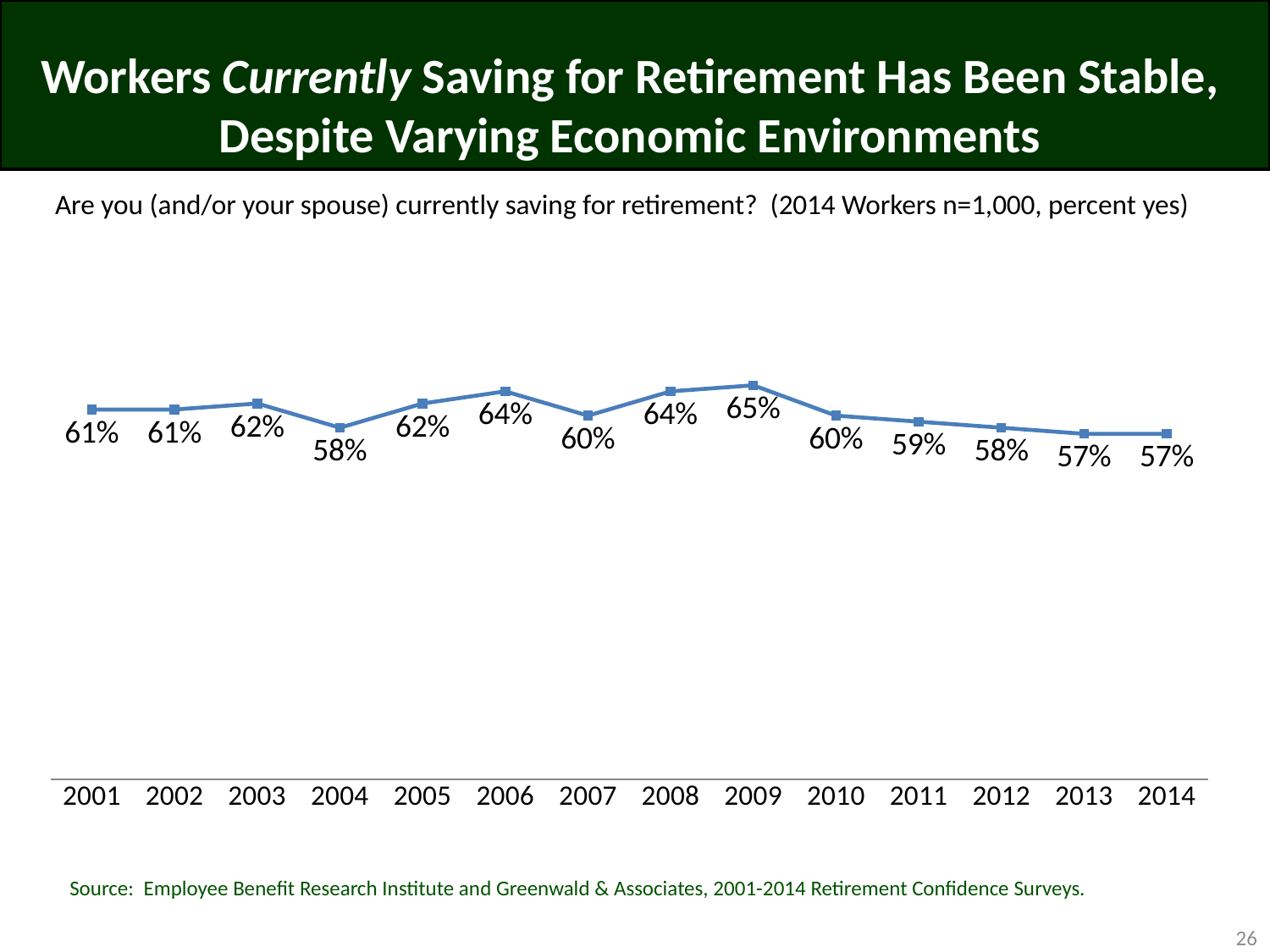
What is the difference between the 2009 value and the 2014 value? 8 percentage points What is the first year shown on the x axis? 2001 What is the value shown for 2014? 57% Do the values rise or fall from 2009 to 2014? Fall How many years are plotted on the chart? 14 Which is larger, the value for 2003 or the value for 2004? 2003 Which year has the highest percentage of workers currently saving for retirement? 2009 Which is larger, the value for 2008 or the value for 2010? 2008 What kind of chart is shown on the slide? Line chart What percentage of workers reported currently saving for retirement in 2009? 65% What is the value shown for 2004? 58% What is the difference between the 2006 value and the 2007 value? 4 percentage points